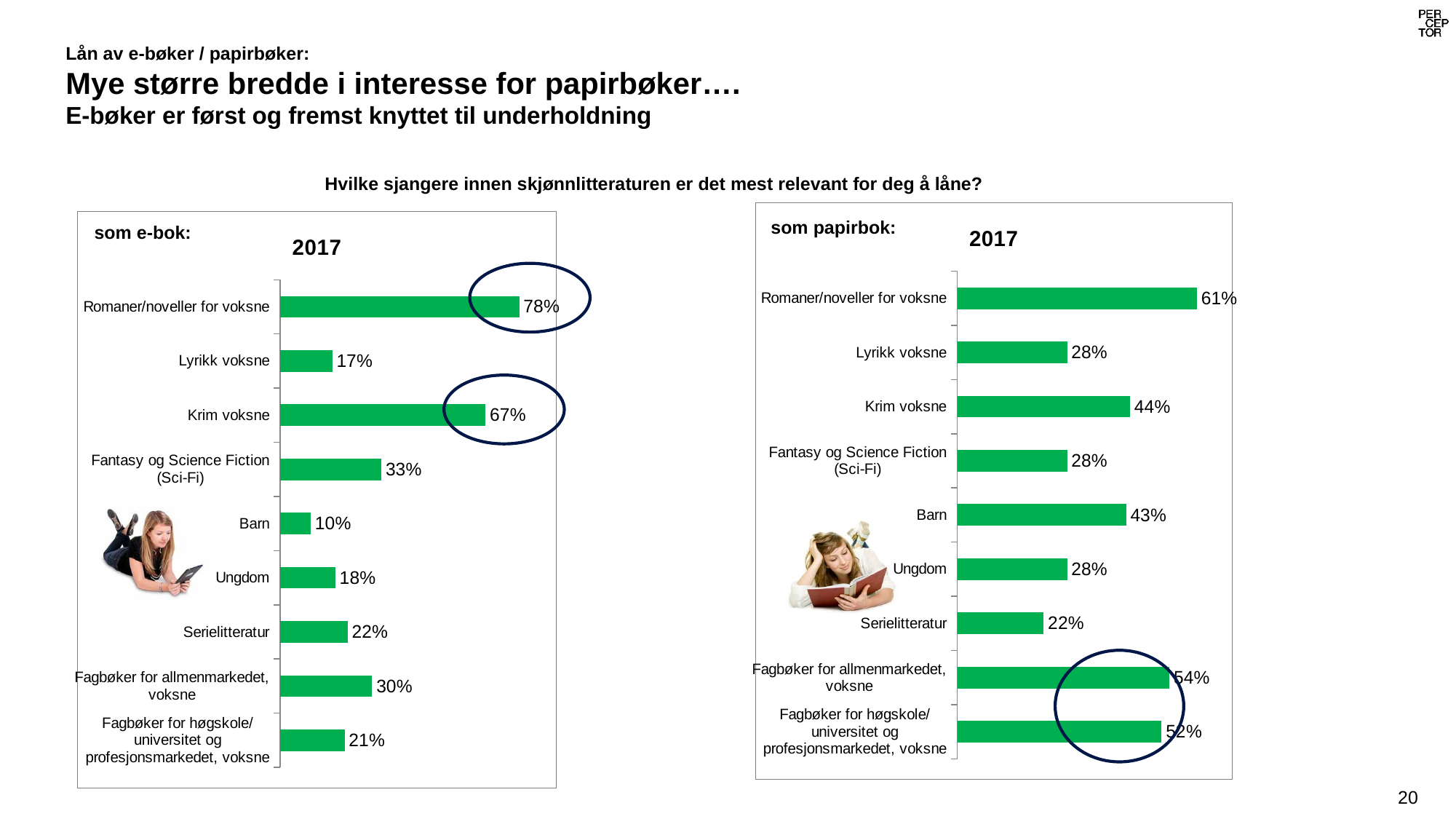
How many categories are shown in the 'som papirbok' chart? 9 In the 'som papirbok' chart, what is the value for Krim voksne? 44% In the 'som e-bok' chart, which category has the lowest value? Barn What year is shown as the title above both charts? 2017 In the 'som e-bok' chart, what is the value for Romaner/noveller for voksne? 78% In the 'som papirbok' chart, what is the value for Fagbøker for høgskole/universitet og profesjonsmarkedet, voksne? 52% In the 'som papirbok' chart, which category has the highest value? Romaner/noveller for voksne In the 'som e-bok' chart, what is the difference between Romaner/noveller for voksne and Krim voksne? 11% Which chart shows a higher value for Barn, 'som e-bok' or 'som papirbok'? som papirbok In the 'som papirbok' chart, what is the difference between Fagbøker for allmenmarkedet, voksne and Serielitteratur? 32% What kind of chart is the 'som e-bok' chart? Bar chart In the 'som e-bok' chart, which is larger: Fantasy og Science Fiction (Sci-Fi) or Fagbøker for allmenmarkedet, voksne? Fantasy og Science Fiction (Sci-Fi)